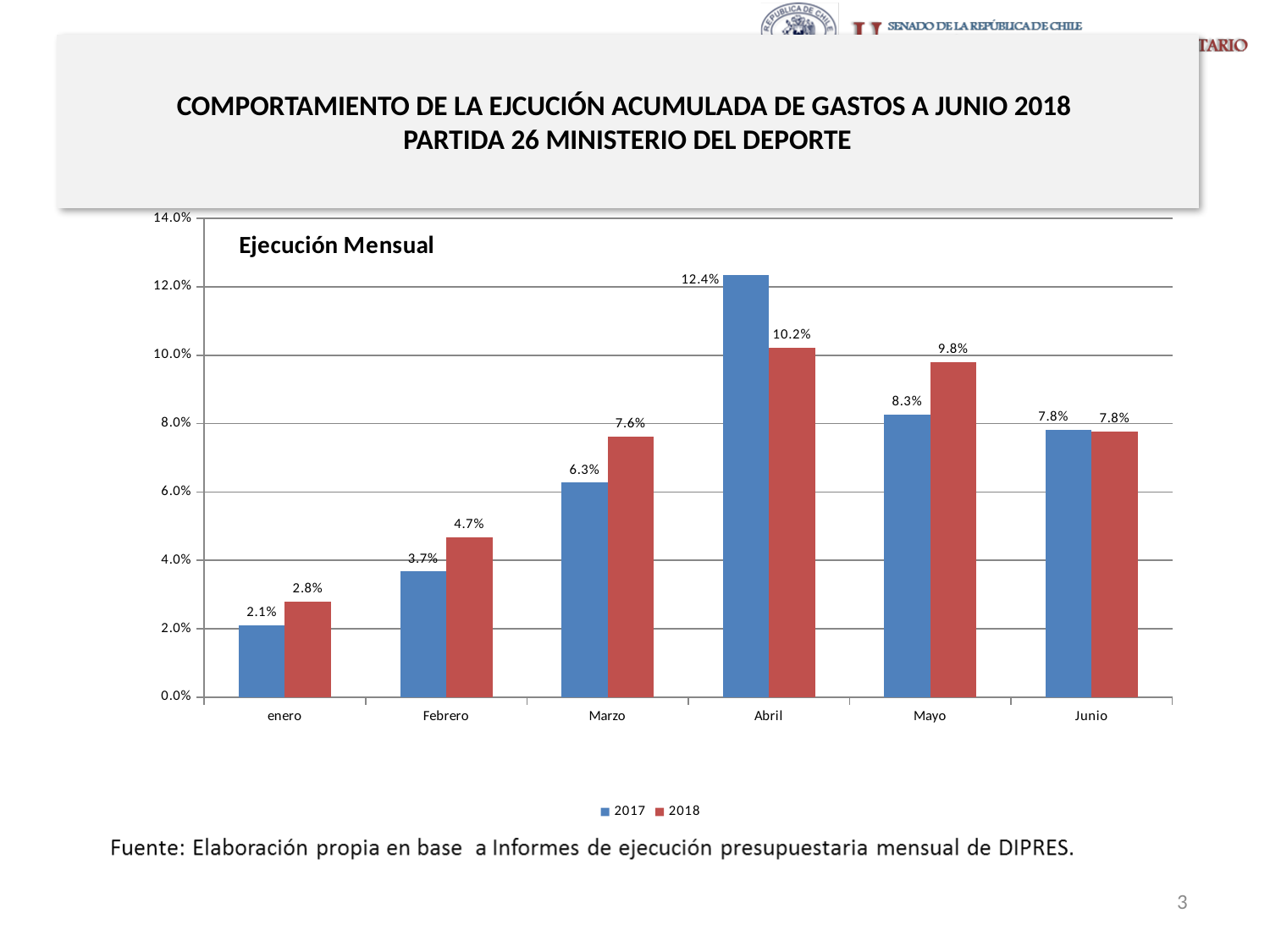
How many months are shown on the x axis? 6 What is the value for 2017 in Abril? 12.4% What is the title shown inside the chart area? Ejecución Mensual How many series does the legend list? 2 What is the value for 2018 in Febrero? 4.7% Is the value for 2018 in Mayo greater or less than 8.0%? greater Which month has the highest value for the 2017 series? Abril What is the difference between the 2018 and 2017 values in Marzo? 1.3% Which month has the lowest value for the 2018 series? enero What is the value for 2018 in Mayo? 9.8% What kind of chart is shown on the slide? bar chart Which is larger in Abril, the 2017 value or the 2018 value? 2017